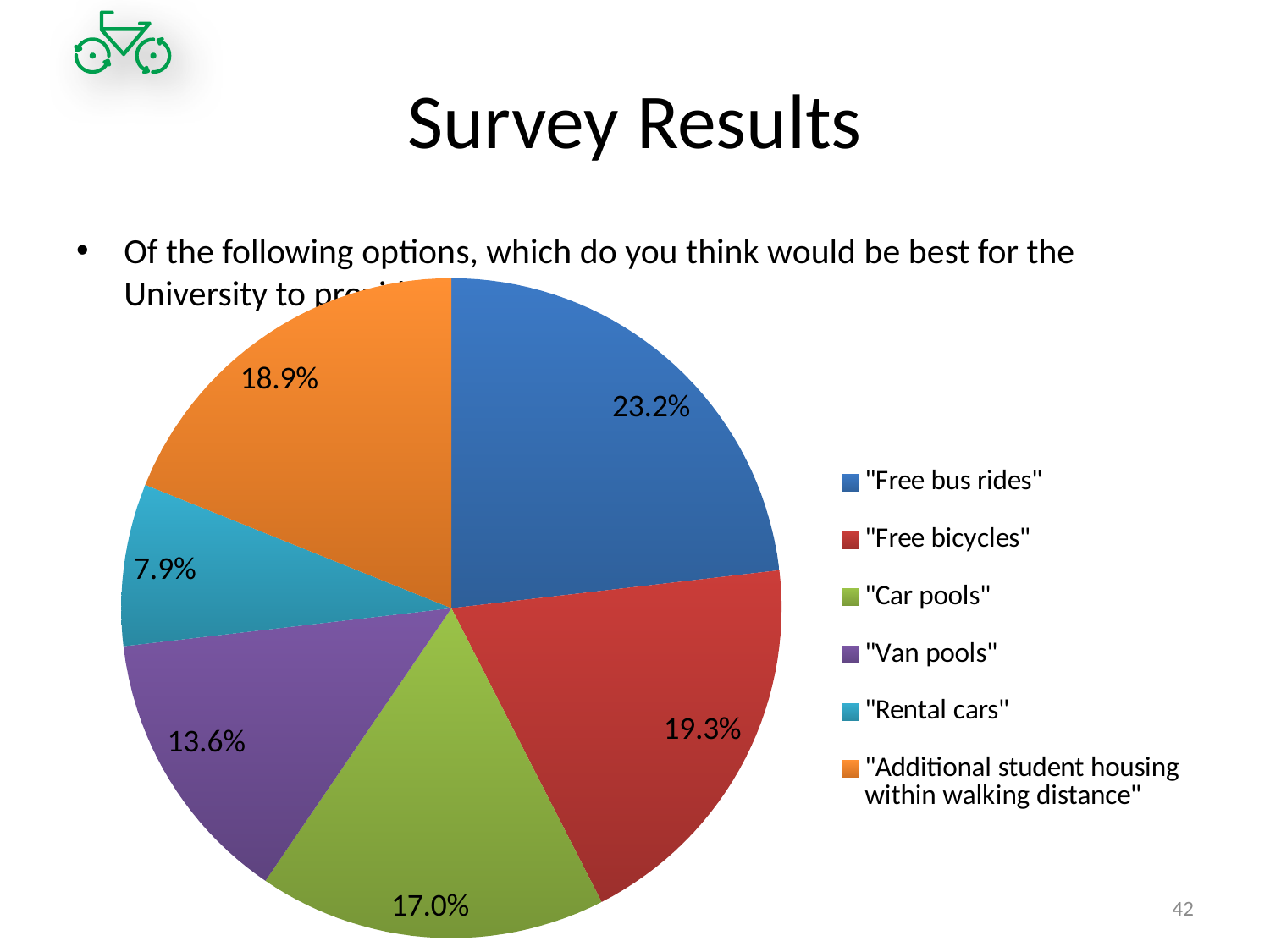
Which is larger, the share for "Free bicycles" or the share for "Additional student housing within walking distance"? "Free bicycles" What percentage is shown for "Additional student housing within walking distance"? 18.9% Which option has the smallest slice of the pie? "Rental cars" What is the difference in percentage points between "Free bus rides" and "Rental cars"? 15.3 What is the value for "Car pools"? 17.0% What percentage is shown for "Van pools"? 13.6% What share of the pie does "Free bus rides" have? 23.2% What percentage is shown for "Free bicycles"? 19.3% What type of chart is shown on the slide? Pie chart Which option has the largest slice of the pie? "Free bus rides" What share does "Rental cars" have? 7.9% How many options are shown in the pie chart? 6